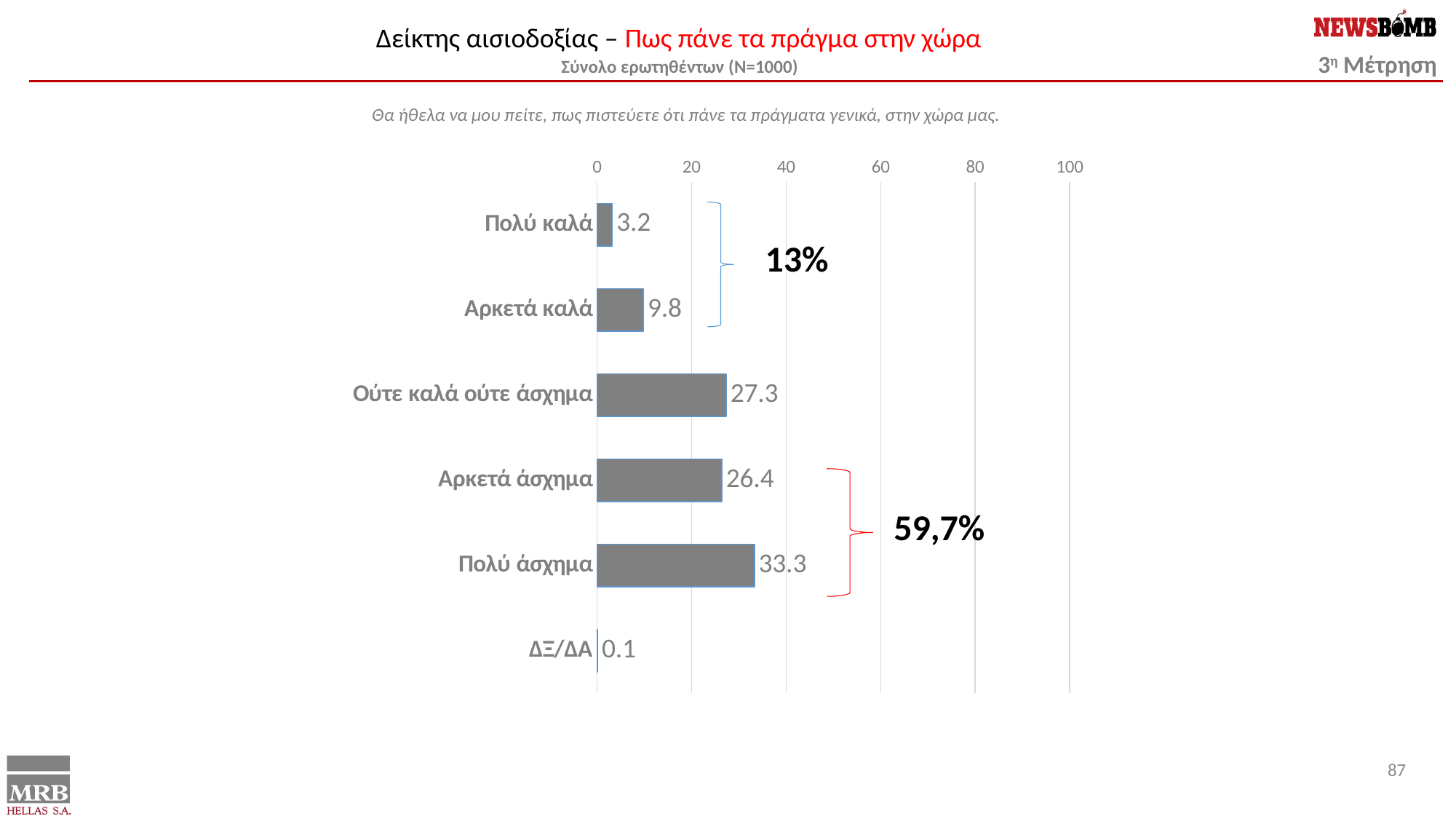
What is the value for Ούτε καλά ούτε άσχημα? 27.3 What is the difference between the values for Πολύ άσχημα and Αρκετά άσχημα? 6.9 What is the value for ΔΞ/ΔΑ? 0.1 What combined percentage is shown by the red bracket next to Αρκετά άσχημα and Πολύ άσχημα? 59,7% Which is larger, the value for Αρκετά καλά or the value for Πολύ καλά? Αρκετά καλά What kind of chart is shown on the slide? Bar chart What is the value for Αρκετά καλά? 9.8 Which category has the highest value? Πολύ άσχημα What is the value for Πολύ άσχημα? 33.3 How many categories are shown in the chart? 6 What is the value for Πολύ καλά? 3.2 Which category has the lowest value? ΔΞ/ΔΑ